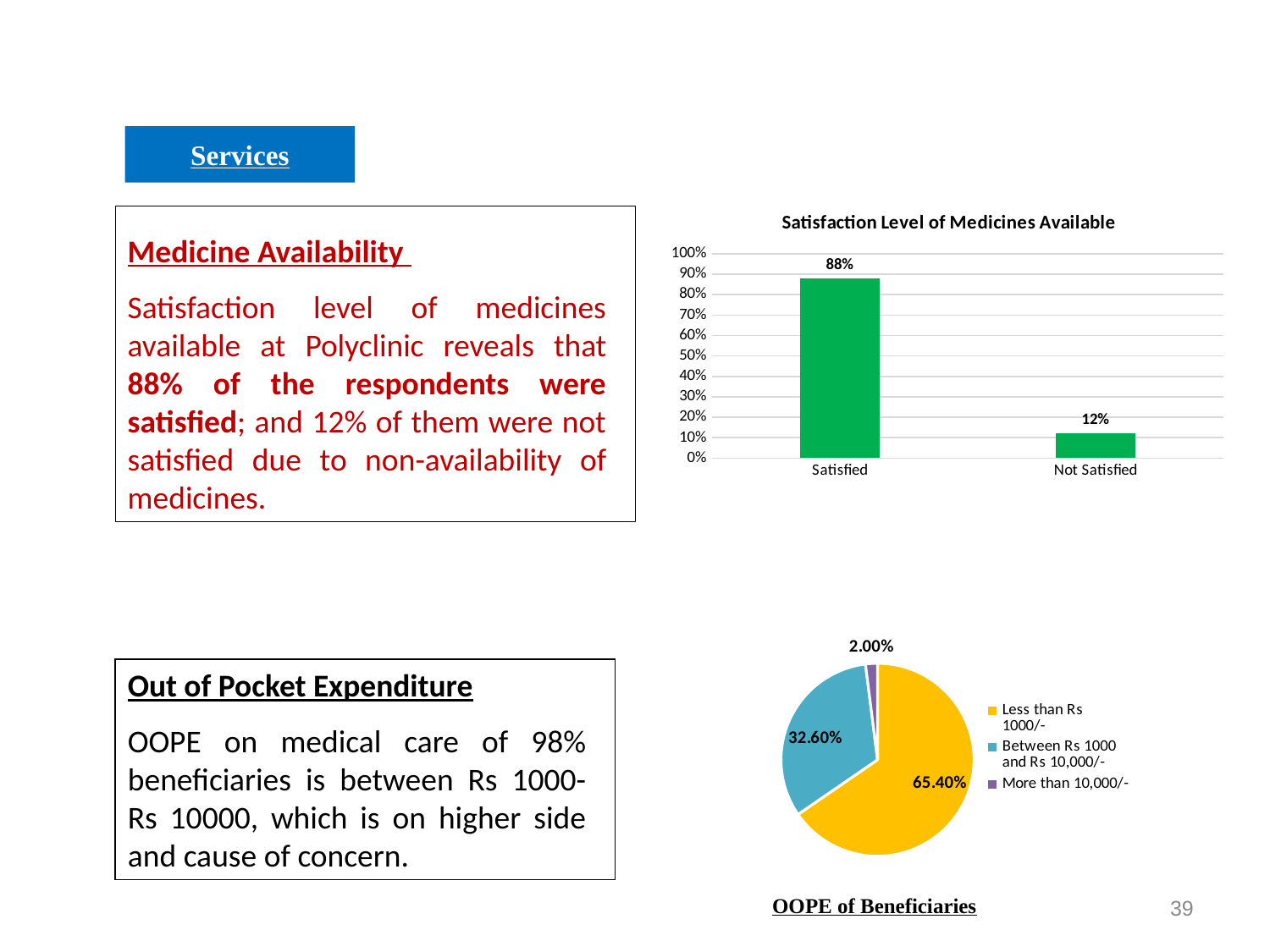
In the 'Satisfaction Level of Medicines Available' chart, how many categories are shown on the x axis? 2 In the 'OOPE of Beneficiaries' pie chart, which category has the smallest slice? More than 10,000/- In the 'Satisfaction Level of Medicines Available' chart, what is the value for Satisfied? 88% In the 'Satisfaction Level of Medicines Available' chart, which category has the highest value? Satisfied What kind of chart is 'Satisfaction Level of Medicines Available'? Bar chart What kind of chart is 'OOPE of Beneficiaries'? Pie chart In the 'Satisfaction Level of Medicines Available' chart, what is the value for Not Satisfied? 12% In the 'OOPE of Beneficiaries' pie chart, what is the share for Less than Rs 1000/-? 65.40% In the 'OOPE of Beneficiaries' pie chart, which is larger: Less than Rs 1000/- or Between Rs 1000 and Rs 10,000/-? Less than Rs 1000/- In the 'OOPE of Beneficiaries' pie chart, how many categories does the legend list? 3 In the 'Satisfaction Level of Medicines Available' chart, what is the difference between Satisfied and Not Satisfied? 76% In the 'OOPE of Beneficiaries' pie chart, what is the share for Between Rs 1000 and Rs 10,000/-? 32.60%